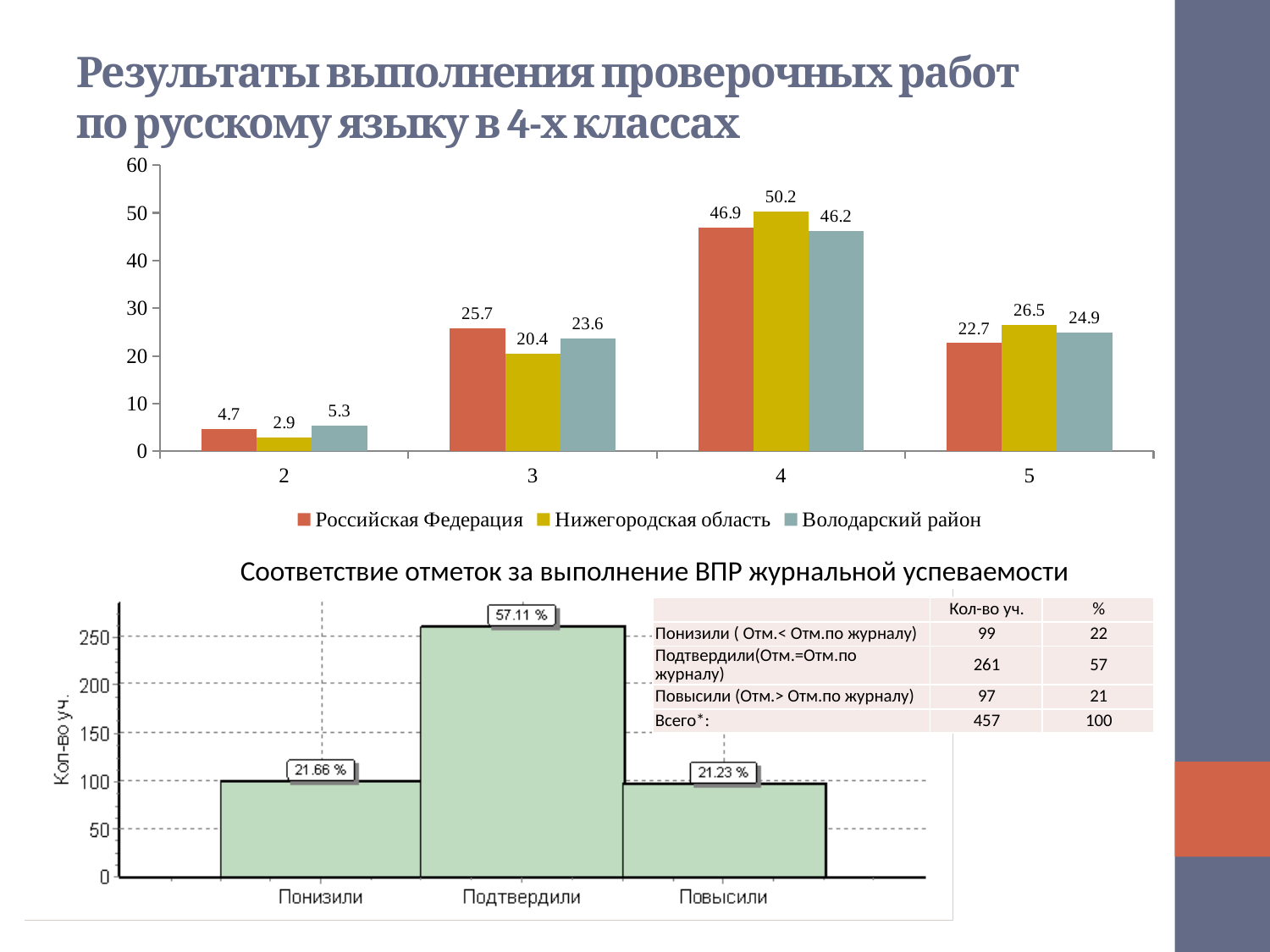
What kind of chart is the bottom chart? bar chart In the top chart, what is the value for Володарский район for category 2? 5.3 In the bottom chart, which category has the highest bar? Подтвердили In the top chart, what is the value for Нижегородская область for category 4? 50.2 In the bottom chart (Соответствие отметок за выполнение ВПР журнальной успеваемости), what percentage is labelled on the Подтвердили bar? 57.11 % In the top chart, what is the difference between Российская Федерация and Нижегородская область for category 3? 5.3 In the top chart, for category 5, which is larger: Нижегородская область or Володарский район? Нижегородская область How many categories are shown on the x axis of the top chart? 4 In the top chart, what is the value for Российская Федерация for category 3? 25.7 In the top chart, which category has the lowest value for Нижегородская область? 2 In the top chart, which category has the highest value for Российская Федерация? 4 How many series does the legend of the top chart list? 3